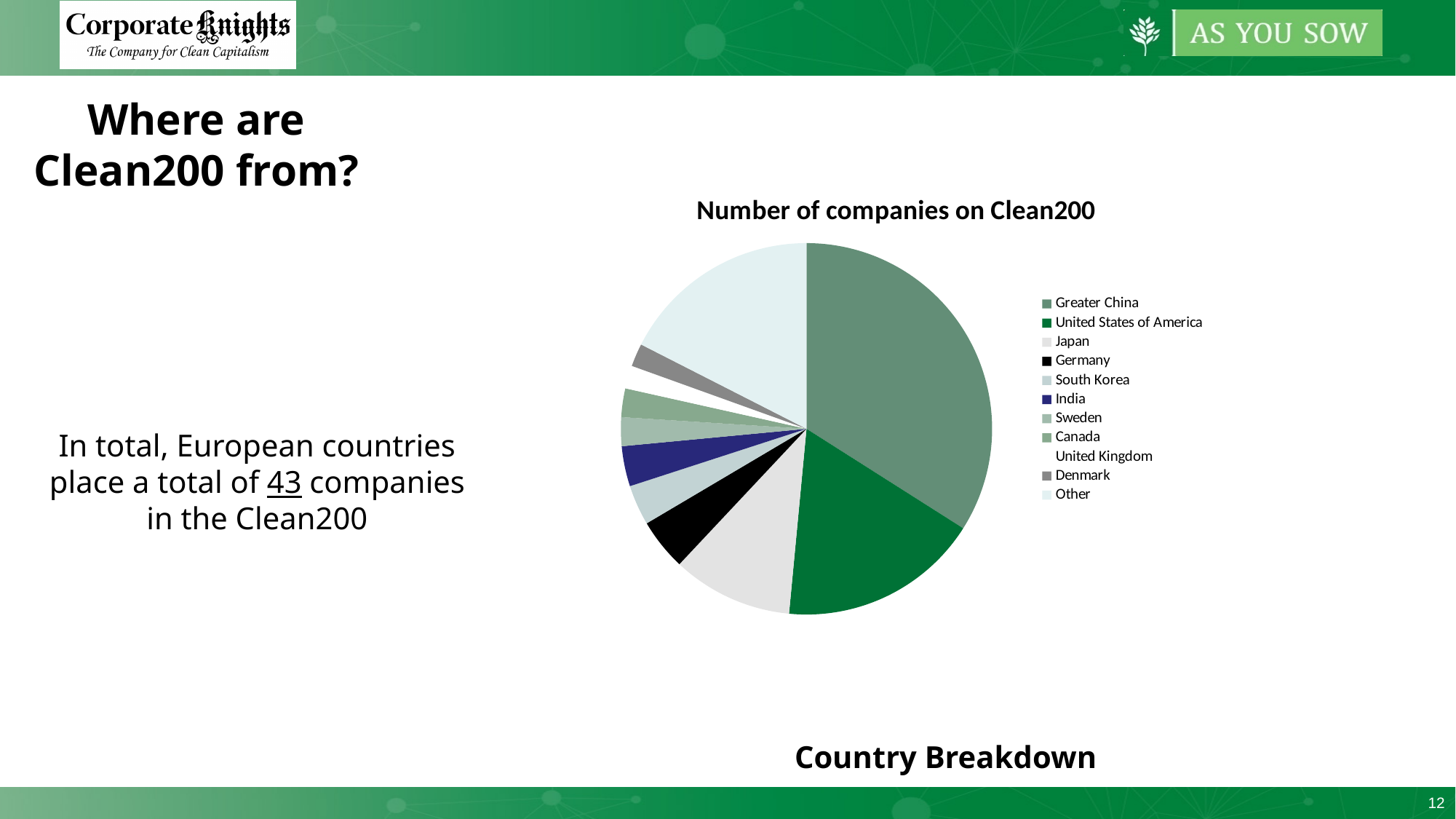
Which slice is larger, India or Denmark? India Which slice is larger, Greater China or United States of America? Greater China Which slice is larger, Japan or Germany? Japan Which category has the largest slice of the pie? Greater China Which legend entry is listed last in the chart's legend? Other What is the title of the chart? Number of companies on Clean200 How many categories does the pie chart's legend list? 11 What kind of chart is shown on the slide? pie chart